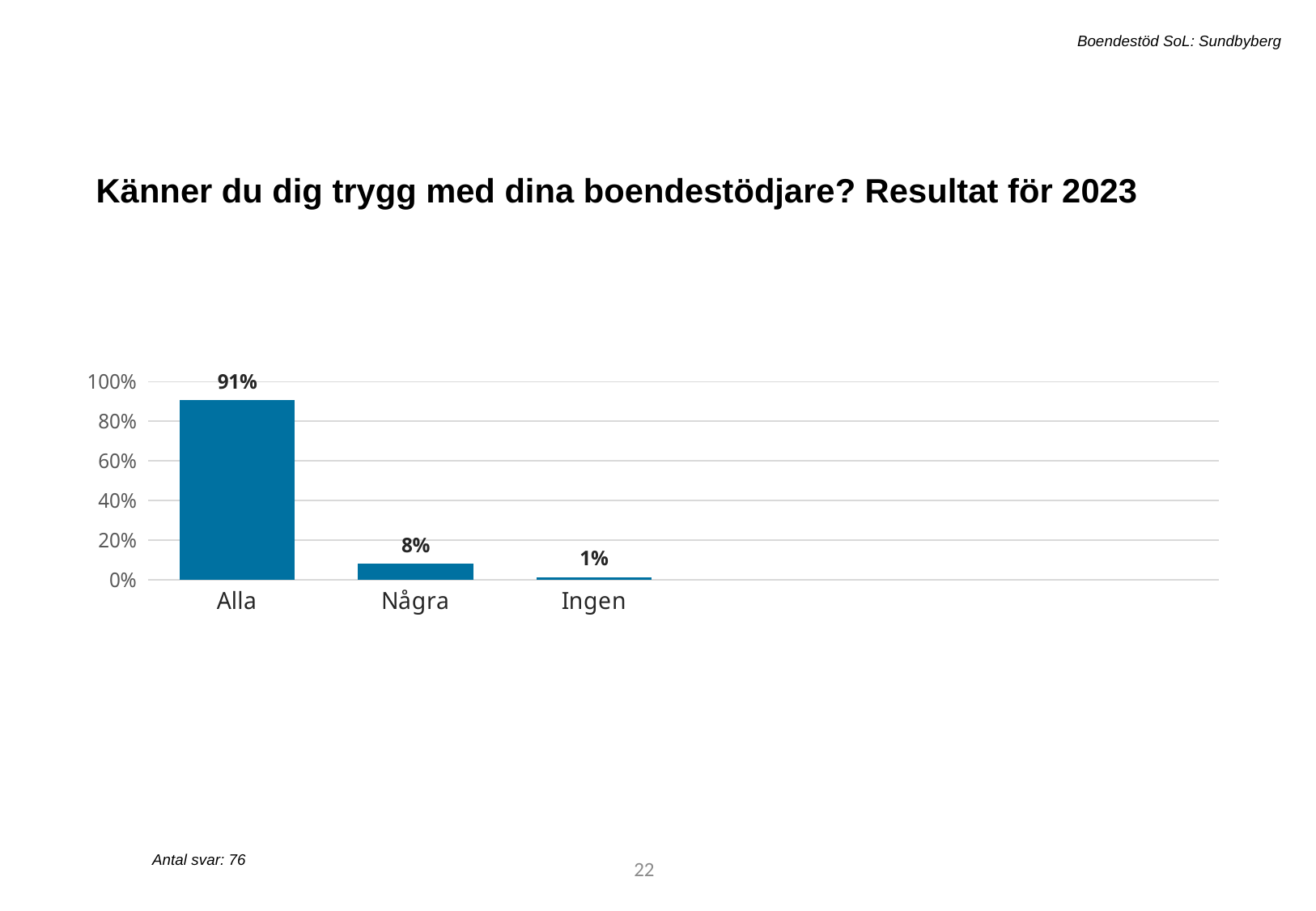
What is the difference between the values for Några and Ingen? 7% What kind of chart is shown on the slide? bar chart What is the value for Ingen? 1% What is the value for Alla? 91% What is the difference between the values for Alla and Några? 83% Which is larger, the value for Några or the value for Ingen? Några Is the value for Alla greater or less than 80%? greater What is the value for Några? 8% How many categories are shown on the x axis? 3 Do the values rise or fall from left to right along the x axis? fall Which category has the highest value? Alla Which category has the lowest value? Ingen